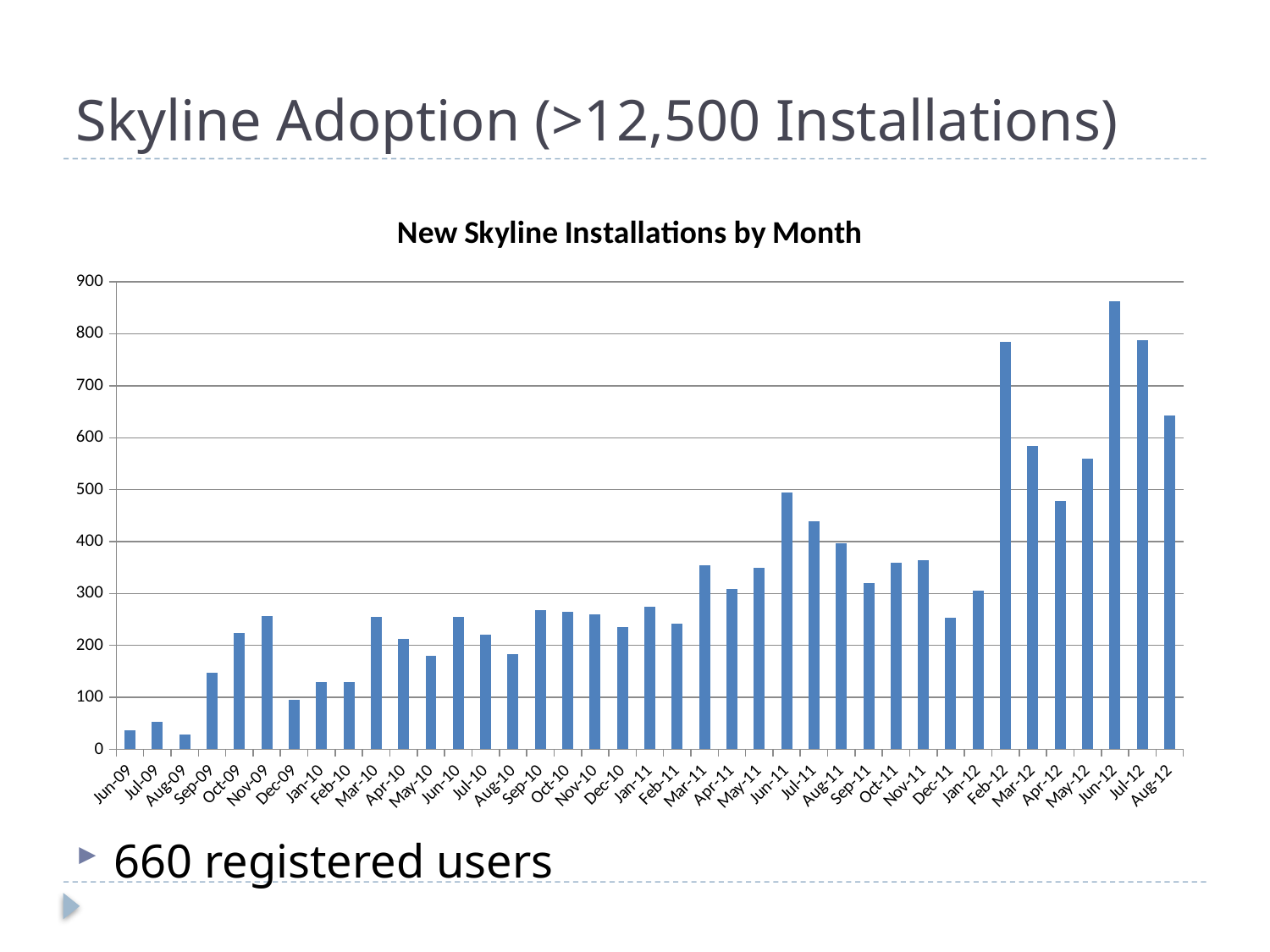
Which month has more new installations, Feb-12 or Mar-12? Feb-12 What is the title of the chart? New Skyline Installations by Month Overall, do new installations rise or fall from Jun-09 to Aug-12? rise Which month has more new installations, Jun-12 or Jul-12? Jun-12 What kind of chart is shown on the slide? bar chart Is the value for Aug-12 greater or less than 600? greater Which month has the highest number of new installations? Jun-12 Is the value for Jun-11 greater or less than 400? greater Is the value for Feb-12 greater or less than 700? greater Which month has the lowest number of new installations? Aug-09 How many months are plotted on the x axis of the chart? 39